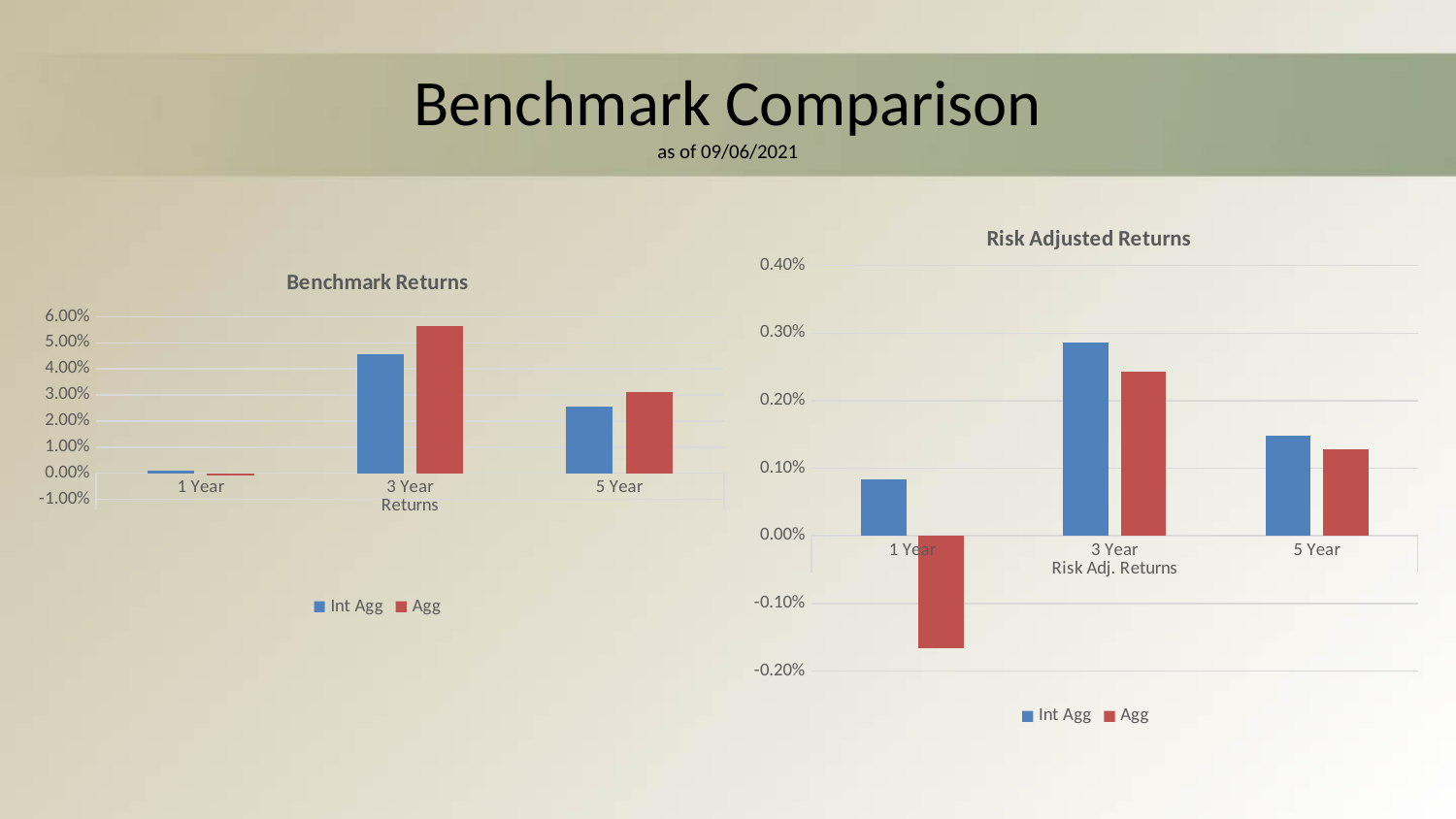
In the Risk Adjusted Returns chart, is the Agg value for 1 Year greater or less than 0.00%? less In the Risk Adjusted Returns chart, is the Int Agg value for 3 Year greater or less than 0.20%? greater In the Risk Adjusted Returns chart, do the Int Agg values rise or fall from 3 Year to 5 Year? fall How many categories are shown on the x axis of the Benchmark Returns chart? 3 In the Benchmark Returns chart, which category has the highest Agg value? 3 Year How many series does the legend of the Risk Adjusted Returns chart list? 2 What kind of chart is the Benchmark Returns chart? bar chart In the Risk Adjusted Returns chart, which is larger for 3 Year: Int Agg or Agg? Int Agg In the Risk Adjusted Returns chart, which category has the lowest Agg value? 1 Year In the Benchmark Returns chart, is the Agg value for 3 Year greater or less than 5.00%? greater In the Benchmark Returns chart, which is larger for 5 Year: Int Agg or Agg? Agg What colour represents the Agg series in the Benchmark Returns chart? red